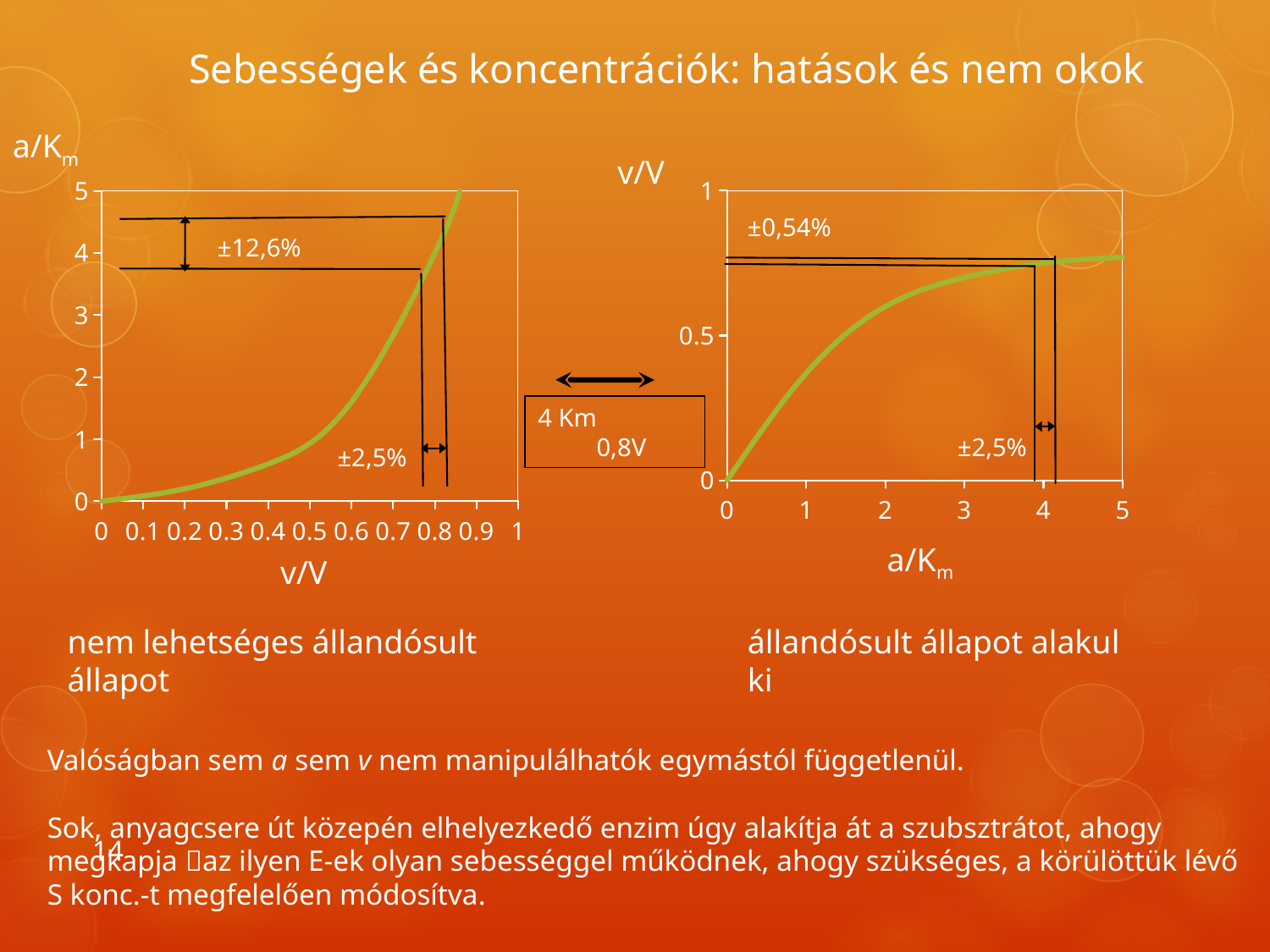
On the right chart, is the value of v/V at a/Km = 2 greater or less than 0.5? greater On the left chart, what percentage variation in v/V is annotated on the x axis? ±2,5% On the left chart, does a/Km rise or fall as v/V increases along the x axis? rise On the left chart, is the value of a/Km at v/V = 0.5 greater or less than 2? less What kind of chart is the left chart (a/Km against v/V)? line chart On the left chart, what percentage variation in a/Km is annotated on the y axis? ±12,6% On the right chart, what percentage variation in v/V is annotated? ±0,54% What is the label of the x axis of the right chart? a/Km On the right chart, does v/V rise or fall as a/Km increases along the x axis? rise What is the maximum value shown on the y axis of the left chart? 5 What kind of chart is the right chart (v/V against a/Km)? line chart On the right chart, is the value of v/V at a/Km = 4 greater or less than 0.5? greater